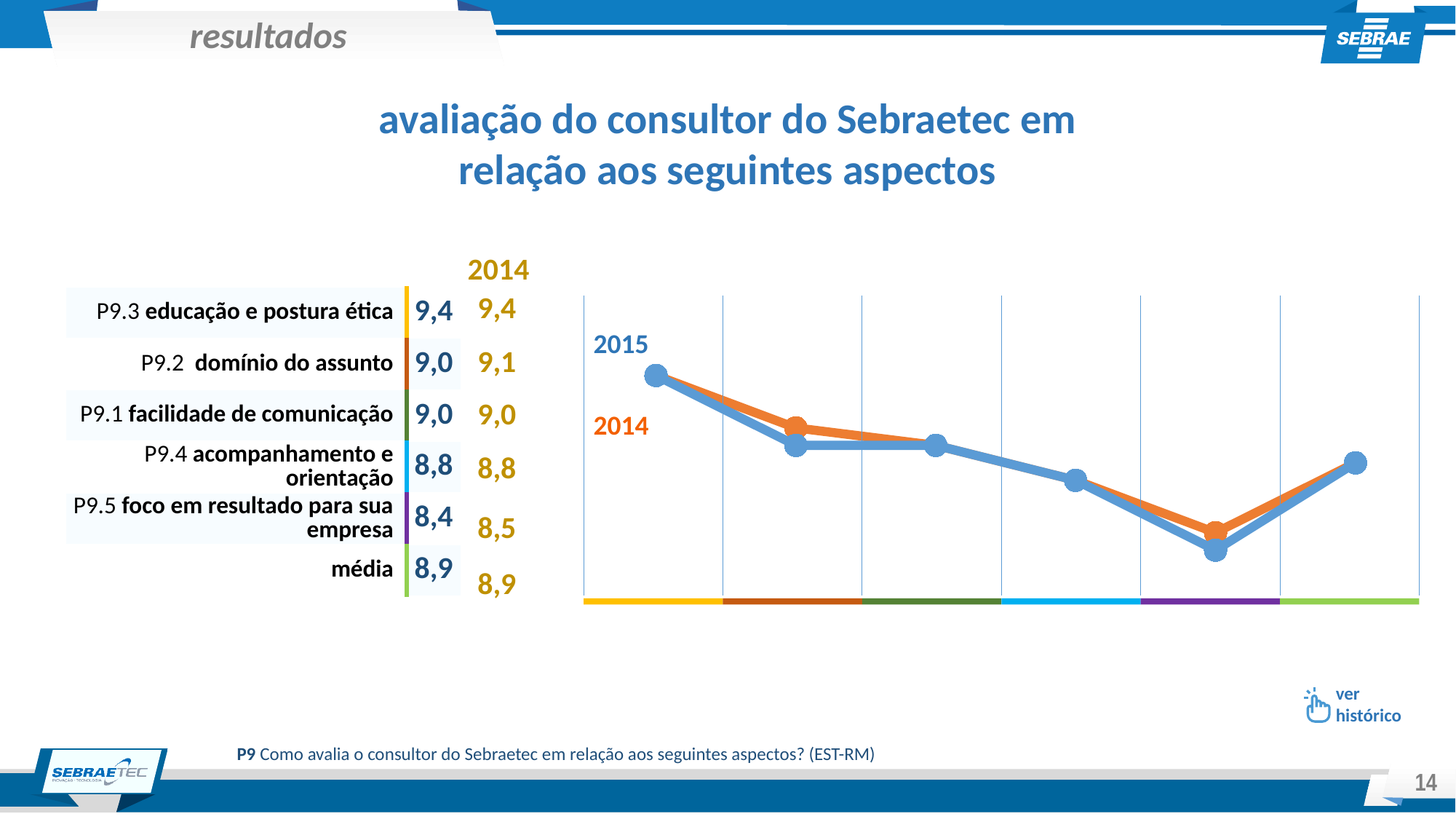
Which aspect has the lowest 2015 value? P9.5 foco em resultado para sua empresa What is the 2014 value for média? 8,9 For P9.5 foco em resultado para sua empresa, which year has the larger value, 2014 or 2015? 2014 What kind of chart is shown on the slide? line chart What is the 2014 value for P9.2 domínio do assunto? 9,1 How many categories (aspects, including média) are plotted along the x axis of the line chart? 6 Which aspect has the highest 2015 value? P9.3 educação e postura ética How many series does the line chart plot? 2 What is the 2015 value for P9.3 educação e postura ética? 9,4 What is the difference between the 2015 values for P9.3 educação e postura ética and P9.5 foco em resultado para sua empresa? 1,0 Which colour is used for the 2014 line in the chart? orange What is the 2015 value for P9.5 foco em resultado para sua empresa? 8,4